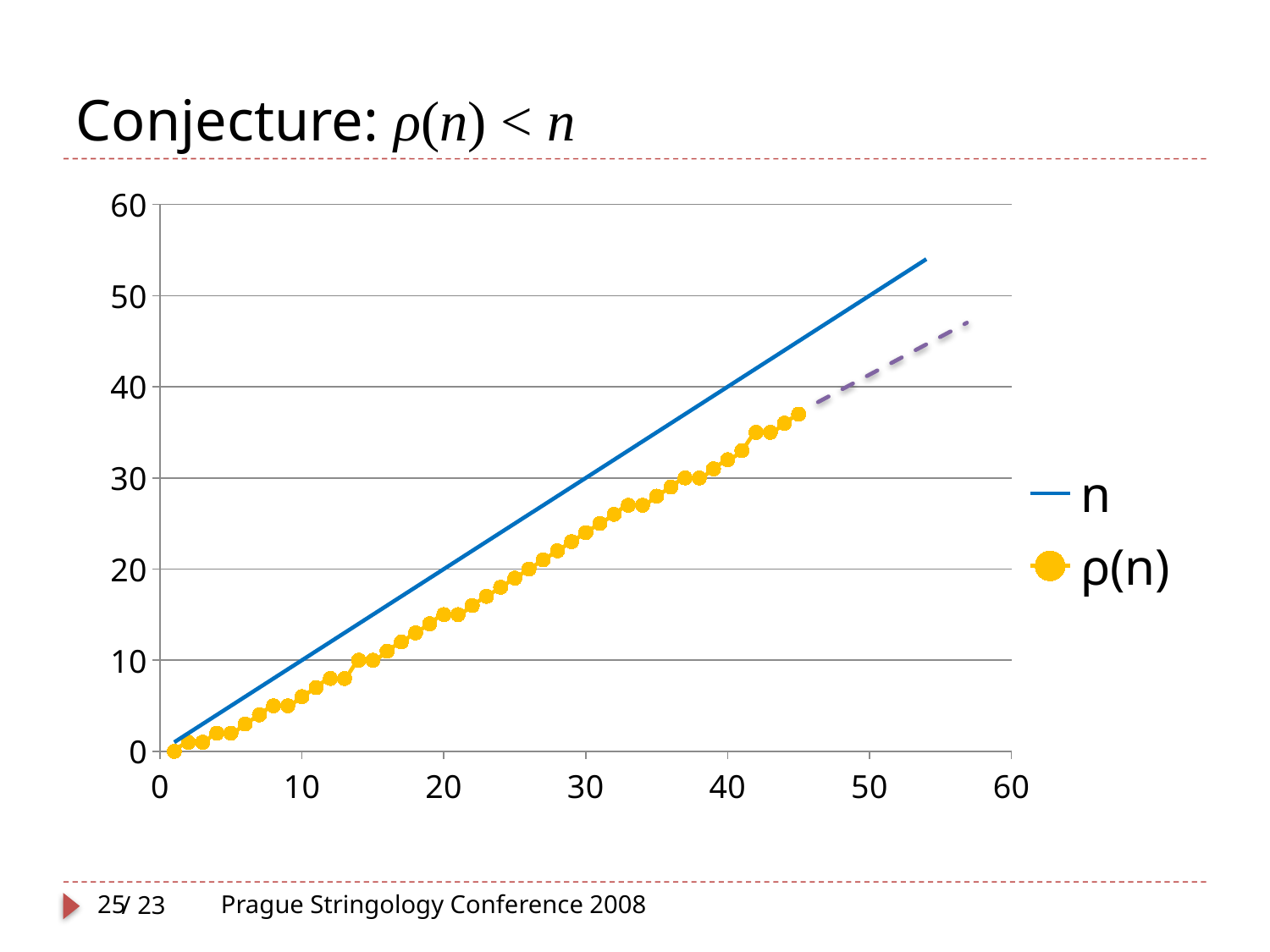
Is the value of ρ(n) at x = 45 greater or less than 40? less Is the value of ρ(n) at x = 30 greater or less than 20? greater Is the value of ρ(n) at x = 20 greater or less than 10? greater Do the ρ(n) values rise or fall as the x axis increases? rise What kind of chart is shown on the slide? scatter chart At x = 40, which series has the larger value, n or ρ(n)? n What is the highest value shown on the vertical axis? 60 Which colour is used for the ρ(n) series? yellow What is the value of the n series at x = 50? 50 How many series does the legend list? 2 What are the two series named in the legend? n and ρ(n)